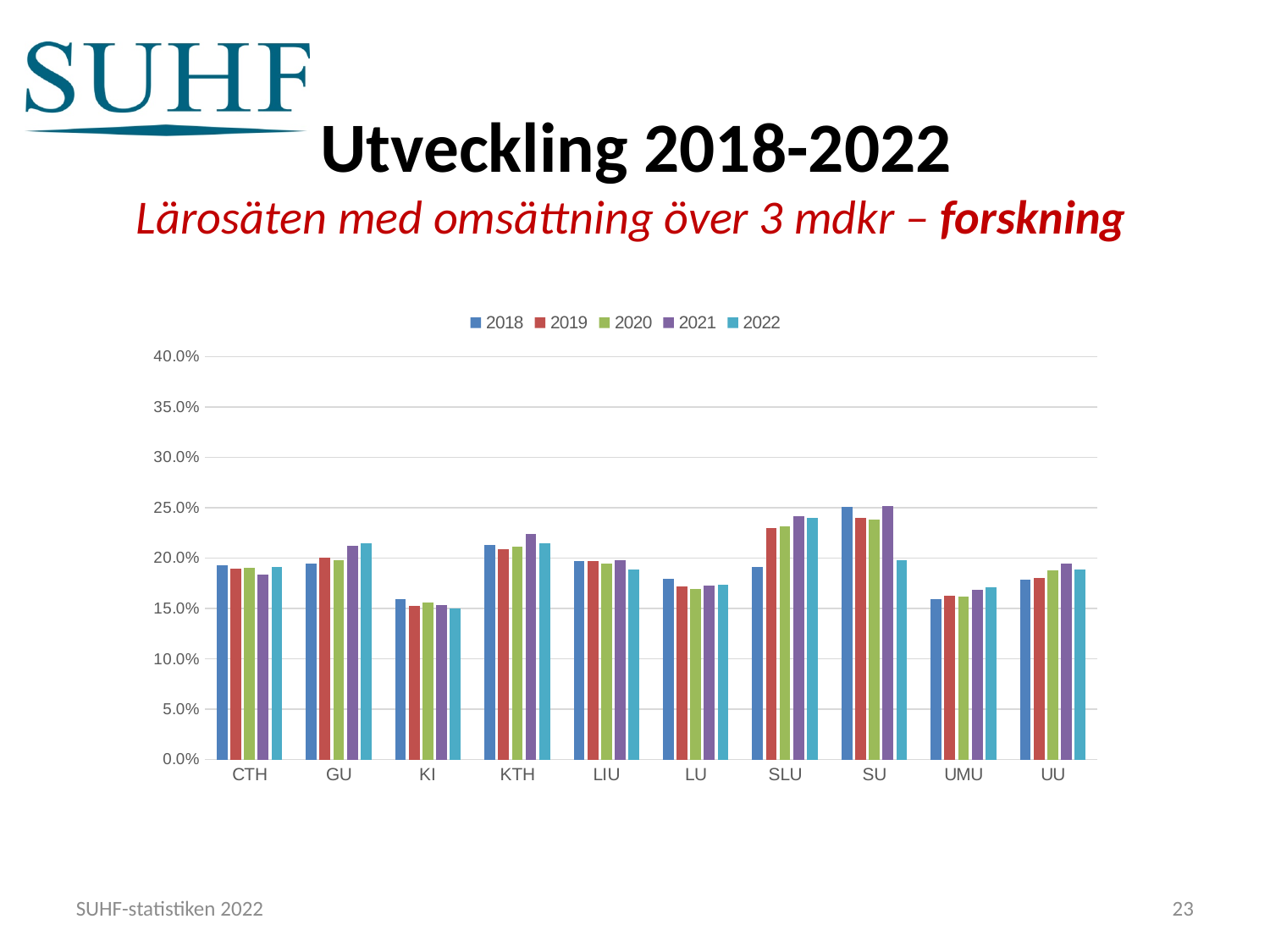
Is the value for KI in 2022 greater or less than 20%? less Which institution has the highest value for 2022? SLU Does the value for SU rise or fall from 2021 to 2022? fall Is the value for KTH in 2021 greater or less than 20%? greater Which institution has the lowest value for 2022? KI How many categories (institutions) are shown on the x axis? 10 Is the value for SLU in 2021 greater or less than 25%? less How many series does the legend list? 5 Which years are listed in the legend? 2018, 2019, 2020, 2021, 2022 What kind of chart is shown on the slide? bar chart Which is larger for SU: the 2018 value or the 2022 value? 2018